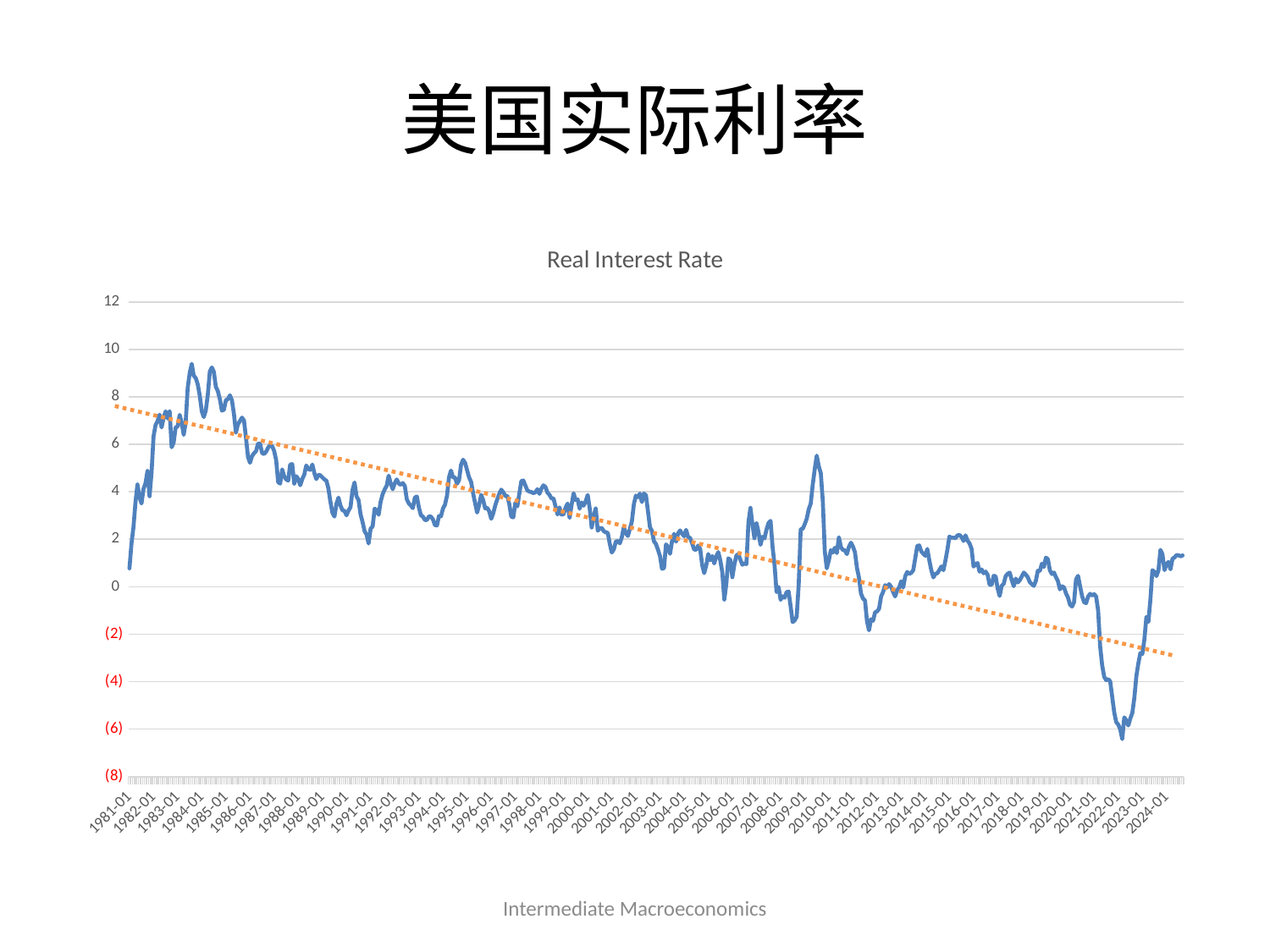
Is the lowest value of the line around 2022 greater or less than (4)? less What is the highest value shown on the vertical axis? 12 Which is lower: the dip around 2012 or the dip around 2022? the dip around 2022 Is the value at the start of the series (1981-01) greater or less than 2? less In which year does the line reach its lowest point? 2022 Is the spike in the line around 2009-01 greater or less than 4? greater What is the title of the chart? Real Interest Rate Overall, does the real interest rate rise or fall from 1981 to 2024? fall Which is higher: the peak of the line around 1984 or the spike around 2009? the peak around 1984 What kind of chart is shown on the slide? line chart Does the dotted trend line slope upward or downward across the chart? downward